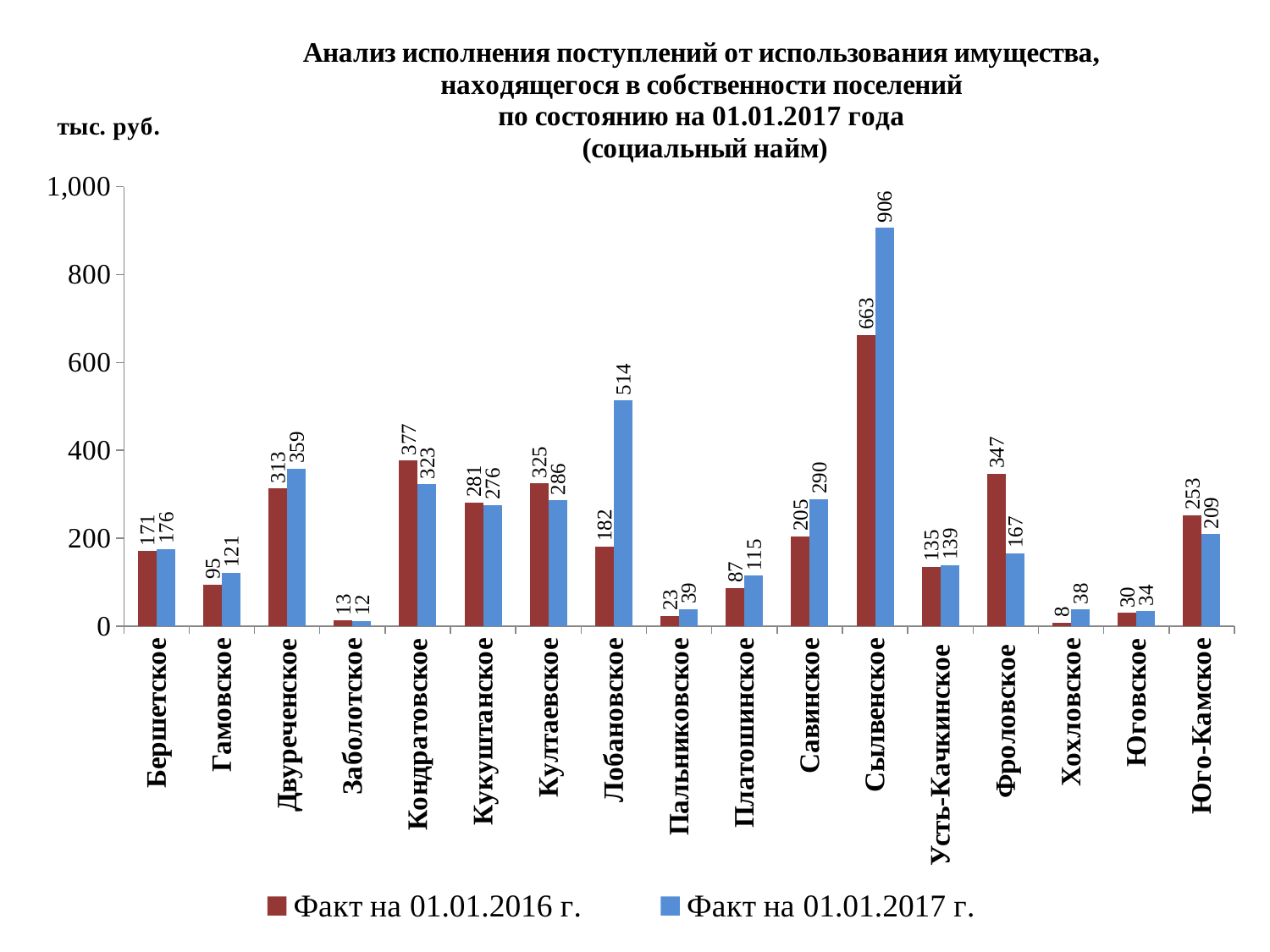
How many categories (settlements) are shown on the x axis? 17 What is the difference between the Факт на 01.01.2016 г. and Факт на 01.01.2017 г. values for Фроловское? 180 Which category has the lowest value in the series Факт на 01.01.2016 г.? Хохловское Which category has the highest value in the series Факт на 01.01.2017 г.? Сылвенское Is the value for Сылвенское in the series Факт на 01.01.2017 г. greater or less than 800? greater What is the difference between the Факт на 01.01.2017 г. and Факт на 01.01.2016 г. values for Сылвенское? 243 How many series does the legend list? 2 What is the value for Лобановское in the series Факт на 01.01.2017 г.? 514 What kind of chart is shown on the slide? bar chart Which is larger for Кондратовское: the Факт на 01.01.2016 г. value or the Факт на 01.01.2017 г. value? Факт на 01.01.2016 г. What is the value for Фроловское in the series Факт на 01.01.2016 г.? 347 What unit is indicated for the values on the chart? тыс. руб.